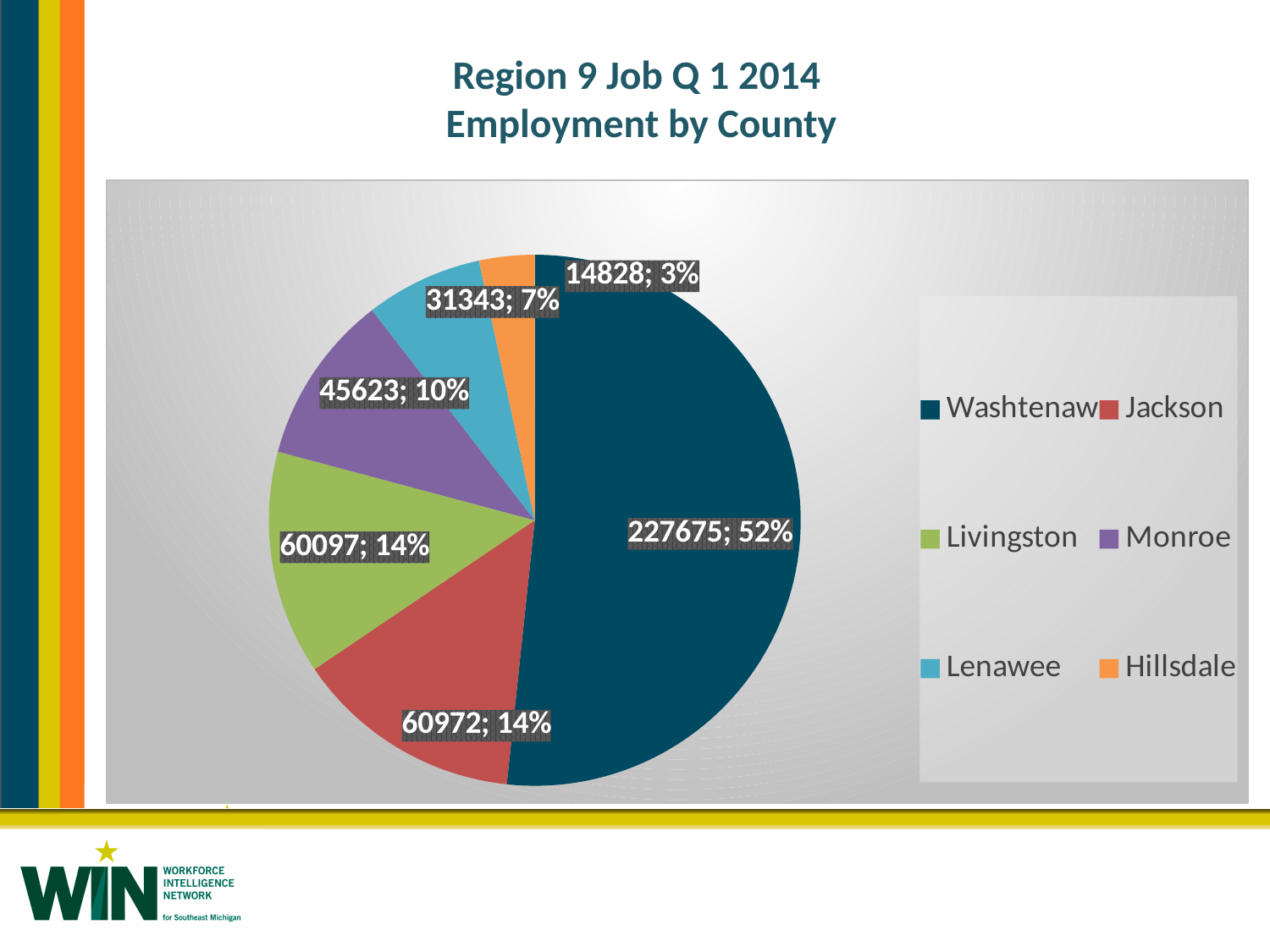
What is the employment value for Hillsdale? 14828 What is the difference between the employment values for Jackson and Livingston? 875 What kind of chart is shown on the slide? pie chart What percentage share of employment does Monroe have? 10% Which has a larger employment value, Monroe or Lenawee? Monroe Which county has the smallest share of employment? Hillsdale How many counties are shown in the pie chart? 6 What percentage share of employment does Washtenaw have? 52% Which county has the largest share of employment? Washtenaw What is the employment value for Monroe? 45623 What is the employment value for Lenawee? 31343 What is the employment value for Washtenaw? 227675